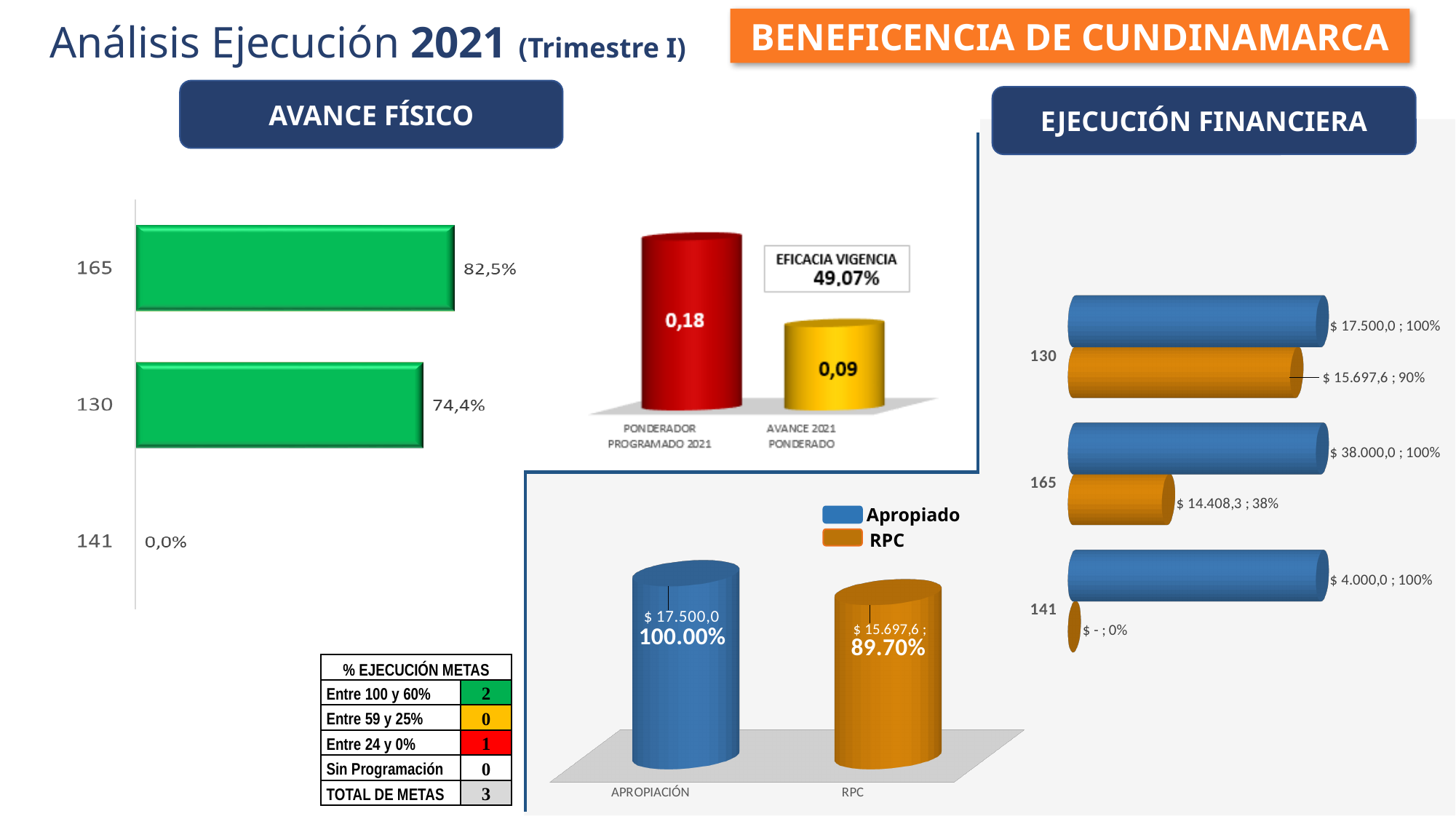
In the EJECUCIÓN FINANCIERA chart on the right, what is the RPC value for category 165? $ 14.408,3 ; 38% In the bottom middle chart with APROPIACIÓN and RPC, which of the two has the larger value? APROPIACIÓN In the cylinder chart in the top middle of the slide, what EFICACIA VIGENCIA percentage is shown? 49,07% In the cylinder chart in the top middle of the slide, what is the value for AVANCE 2021 PONDERADO? 0,09 In the bottom middle chart with APROPIACIÓN and RPC, what percentage is shown for RPC? 89.70% In the green horizontal bar chart under AVANCE FÍSICO, how many categories are shown? 3 In the green horizontal bar chart under AVANCE FÍSICO, what is the difference between the values for 165 and 130? 8,1% In the EJECUCIÓN FINANCIERA chart on the right, how many series does the legend list? 2 In the green horizontal bar chart under AVANCE FÍSICO, which category has the lowest value? 141 In the green horizontal bar chart under AVANCE FÍSICO, what is the value for category 130? 74,4% In the cylinder chart in the top middle of the slide, what is the value for PONDERADOR PROGRAMADO 2021? 0,18 In the green horizontal bar chart under AVANCE FÍSICO, what is the value for category 165? 82,5%